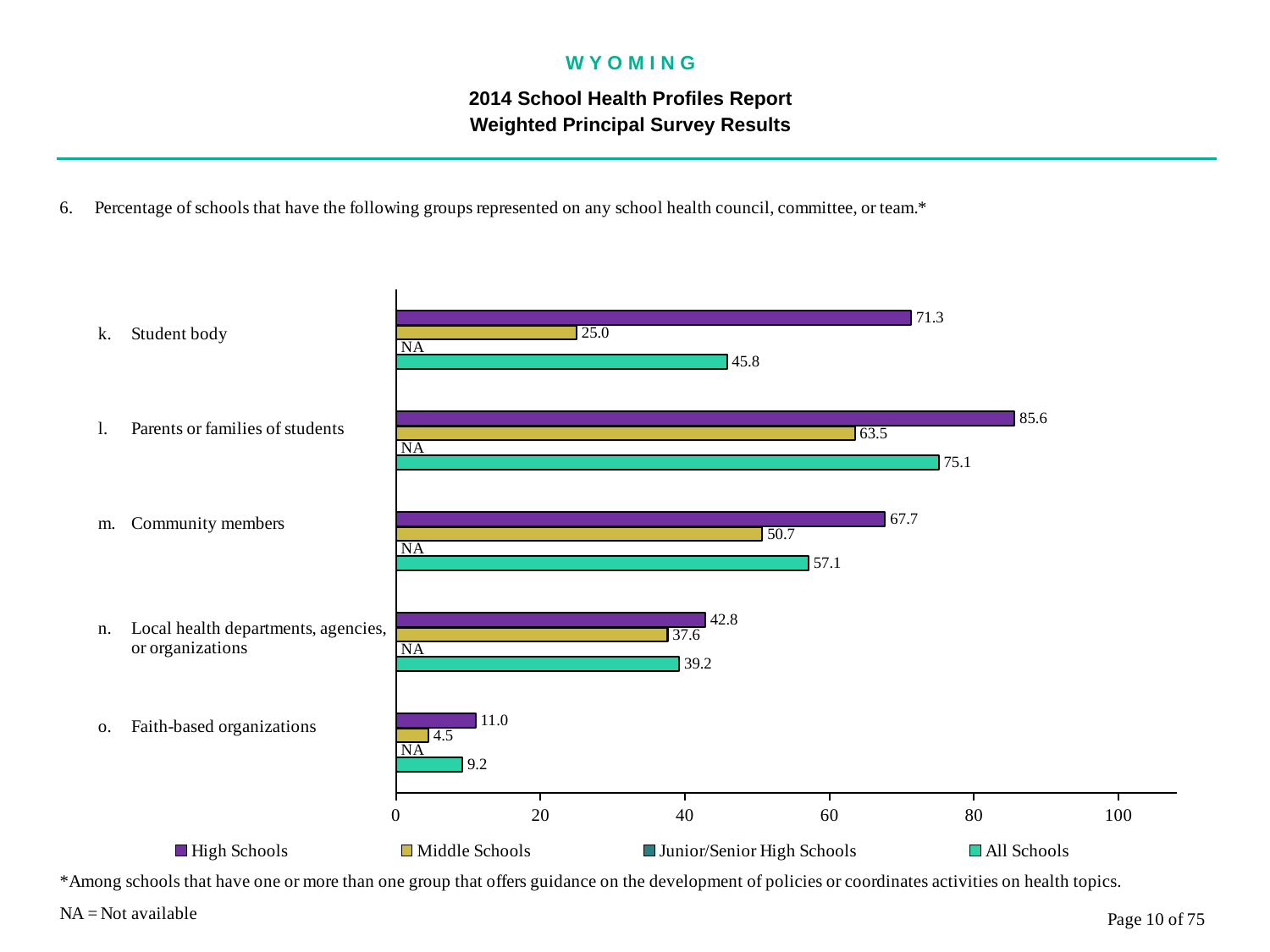
How many series does the legend list? 4 What is the difference between the High Schools and Middle Schools values for Community members? 17.0 What is the value for All Schools for Faith-based organizations? 9.2 What is the value for High Schools for Parents or families of students? 85.6 Which category has the highest value for High Schools? Parents or families of students What is the value for Middle Schools for Student body? 25.0 What kind of chart is shown on the slide? Bar chart Which is larger for Local health departments, agencies, or organizations: the High Schools value or the All Schools value? High Schools What does NA stand for according to the slide? Not available How many categories are shown on the chart? 5 Which category has the lowest value for All Schools? Faith-based organizations What value is shown for Junior/Senior High Schools for Student body? NA